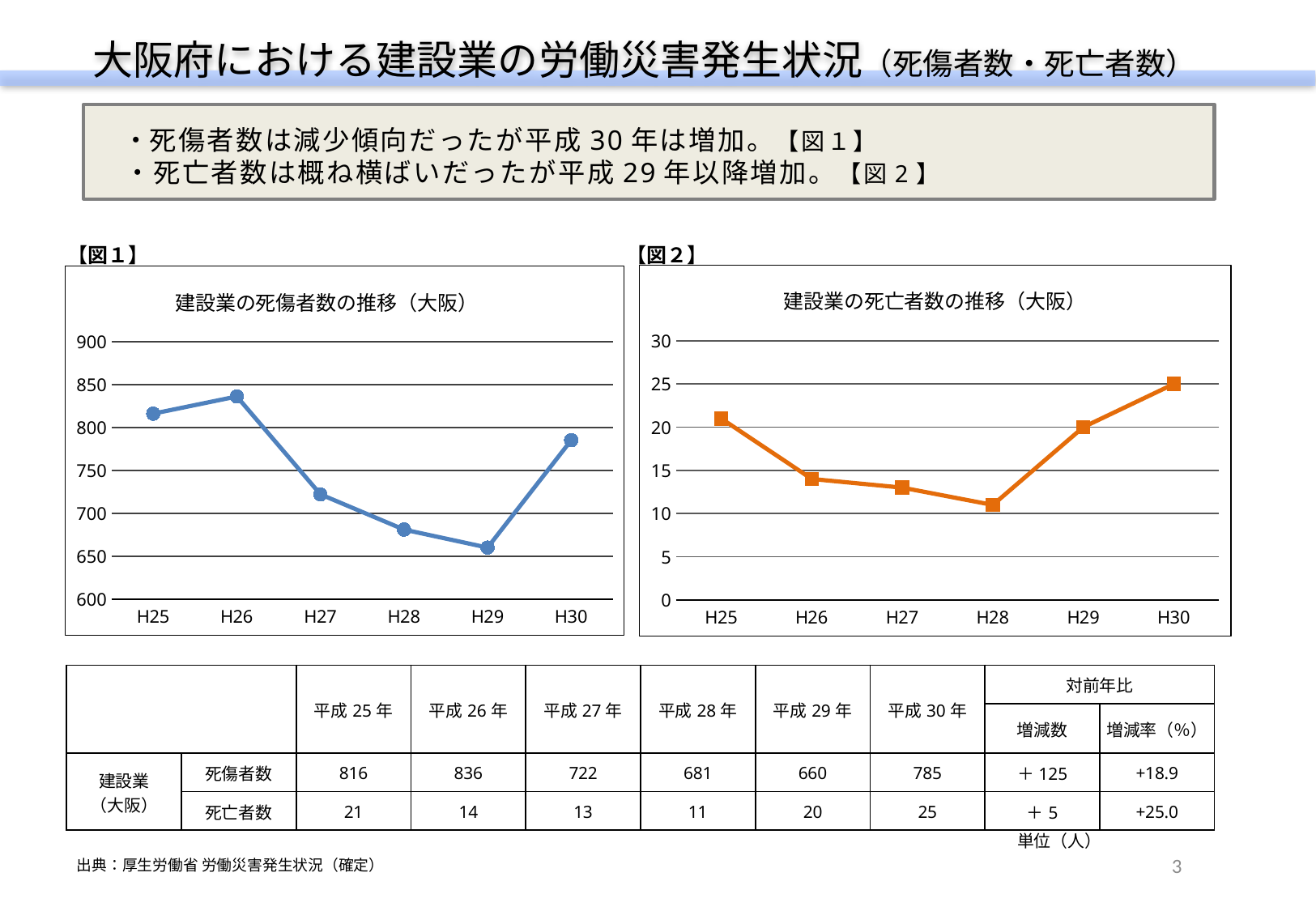
In 【図1】 建設業の死傷者数の推移（大阪）, how many data points are plotted? 6 In 【図2】 建設業の死亡者数の推移（大阪）, which year has the highest value? H30 What type of chart is 【図1】 建設業の死傷者数の推移（大阪）? line chart In 【図1】 建設業の死傷者数の推移（大阪）, what is the difference between H30 and H29 (using the table values)? 125 In 【図2】 建設業の死亡者数の推移（大阪）, do the values rise or fall from H28 to H30? rise In 【図1】 建設業の死傷者数の推移（大阪）, which year has the lowest value? H29 In 【図1】 建設業の死傷者数の推移（大阪）, which year has the highest value? H26 In 【図2】 建設業の死亡者数の推移（大阪）, is the value for H25 greater or less than 20? greater What type of chart is 【図2】 建設業の死亡者数の推移（大阪）? line chart In 【図1】 建設業の死傷者数の推移（大阪）, is the value for H27 greater or less than 750? less In 【図1】 建設業の死傷者数の推移（大阪）, what is the value for H30 (as shown in the table)? 785 In 【図2】 建設業の死亡者数の推移（大阪）, which year has the lowest value? H28